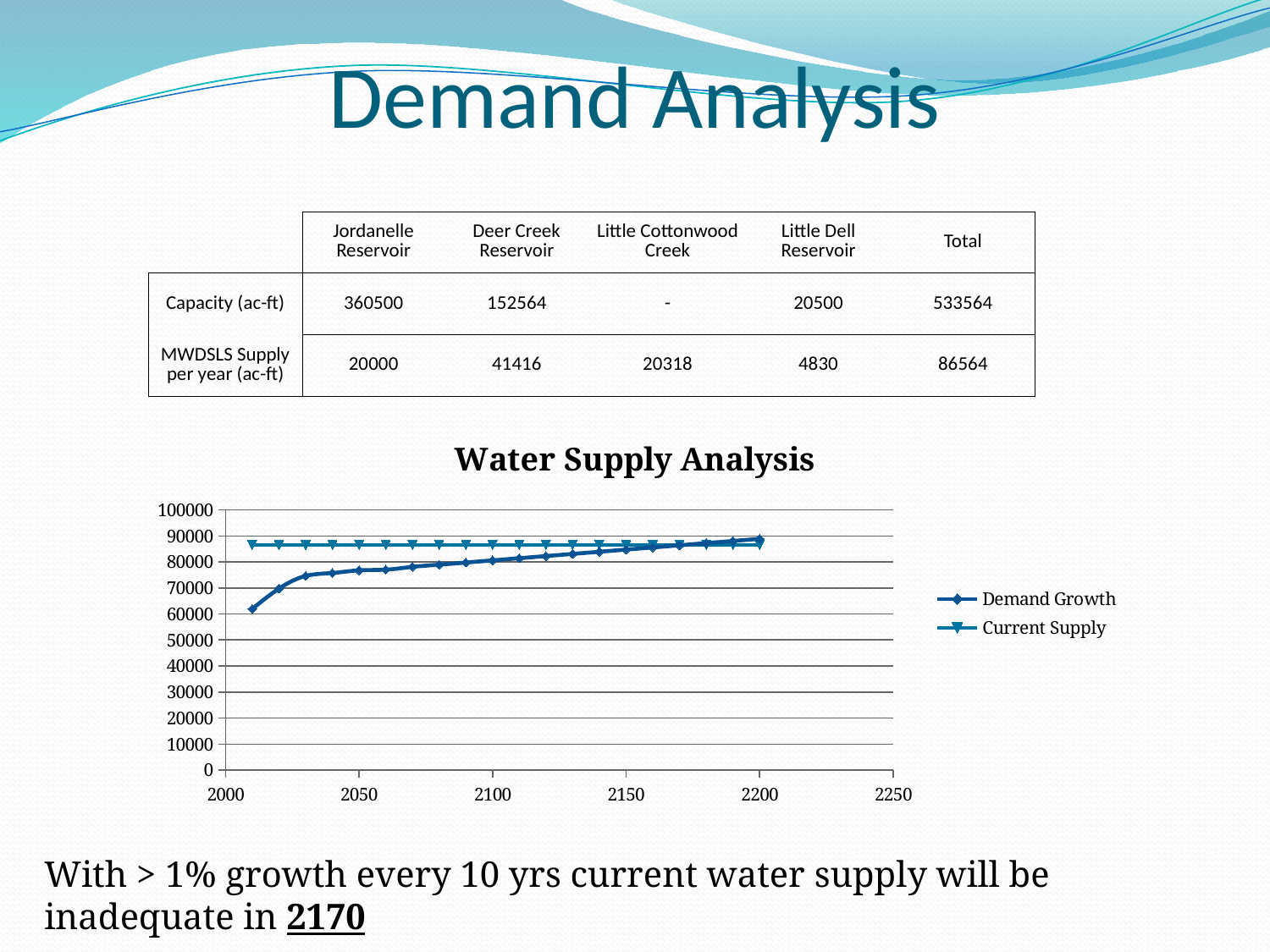
At which year does the Demand Growth series reach its highest plotted value? 2200 What is the title of the chart on the slide? Water Supply Analysis What kind of chart is the Water Supply Analysis chart? line chart Is the Current Supply value greater or less than 80000? greater Is the Demand Growth value at the year 2200 greater or less than 80000? greater In the Water Supply Analysis chart, which series is higher at the year 2050: Demand Growth or Current Supply? Current Supply Is the Current Supply value greater or less than 90000? less What are the two series named in the legend of the Water Supply Analysis chart? Demand Growth and Current Supply How many series does the legend of the Water Supply Analysis chart list? 2 Does the Current Supply series rise, fall, or stay flat across the years shown? stay flat Does the Demand Growth series rise or fall as the year increases along the x axis? rise